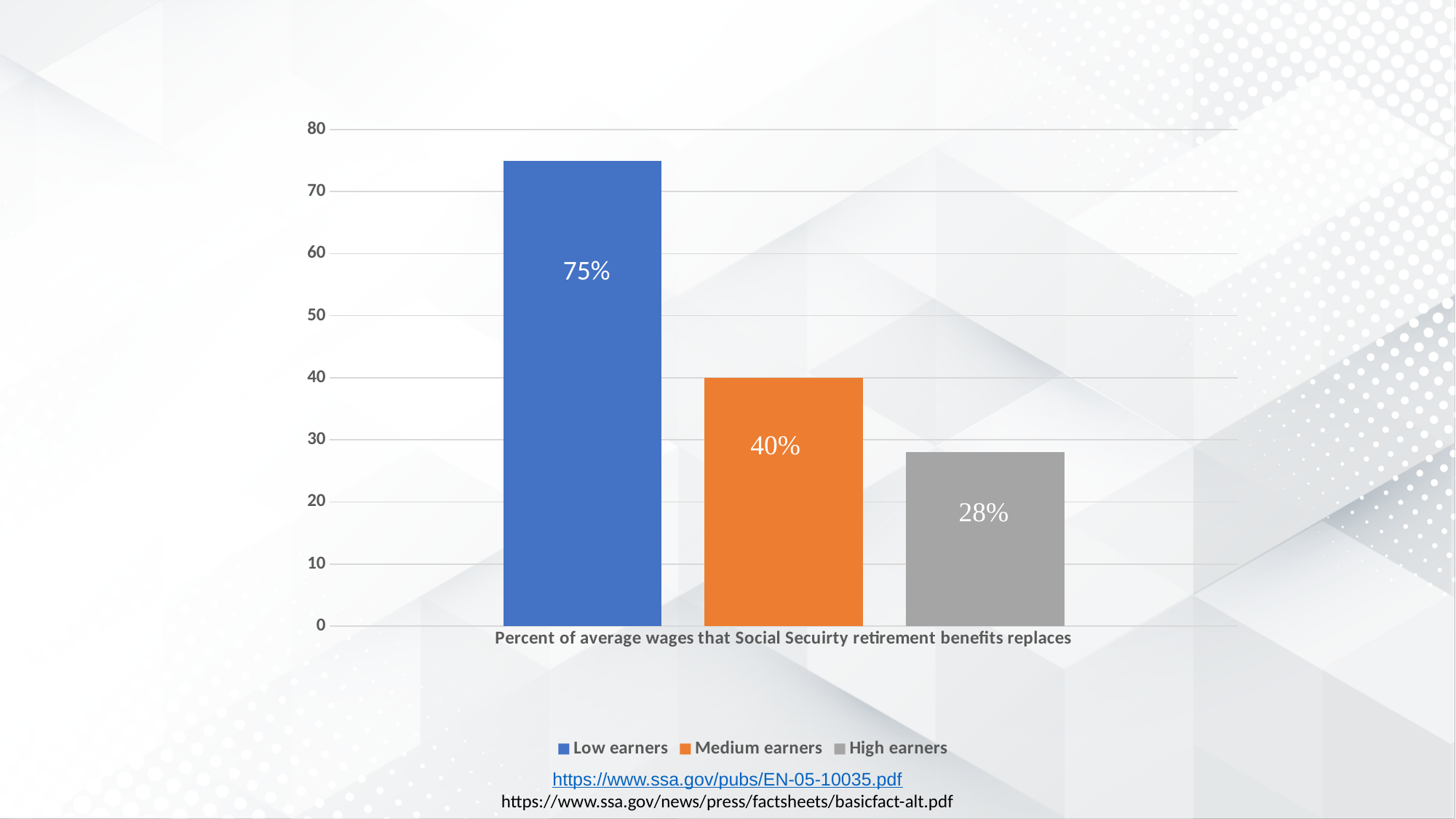
What kind of chart is shown on the slide? Bar chart Which earner group has the highest replacement percentage? Low earners What is the difference between the values for Medium earners and High earners? 12% What is the value shown for Medium earners? 40% Which is larger, the value for Medium earners or High earners? Medium earners Is the value for High earners greater or less than 30? less What percent of average wages does Social Security replace for Low earners? 75% What is the value shown for High earners? 28% What colour is the bar for Medium earners? Orange What is the difference between the values for Low earners and Medium earners? 35% How many series does the legend list? 3 Which earner group has the lowest replacement percentage? High earners